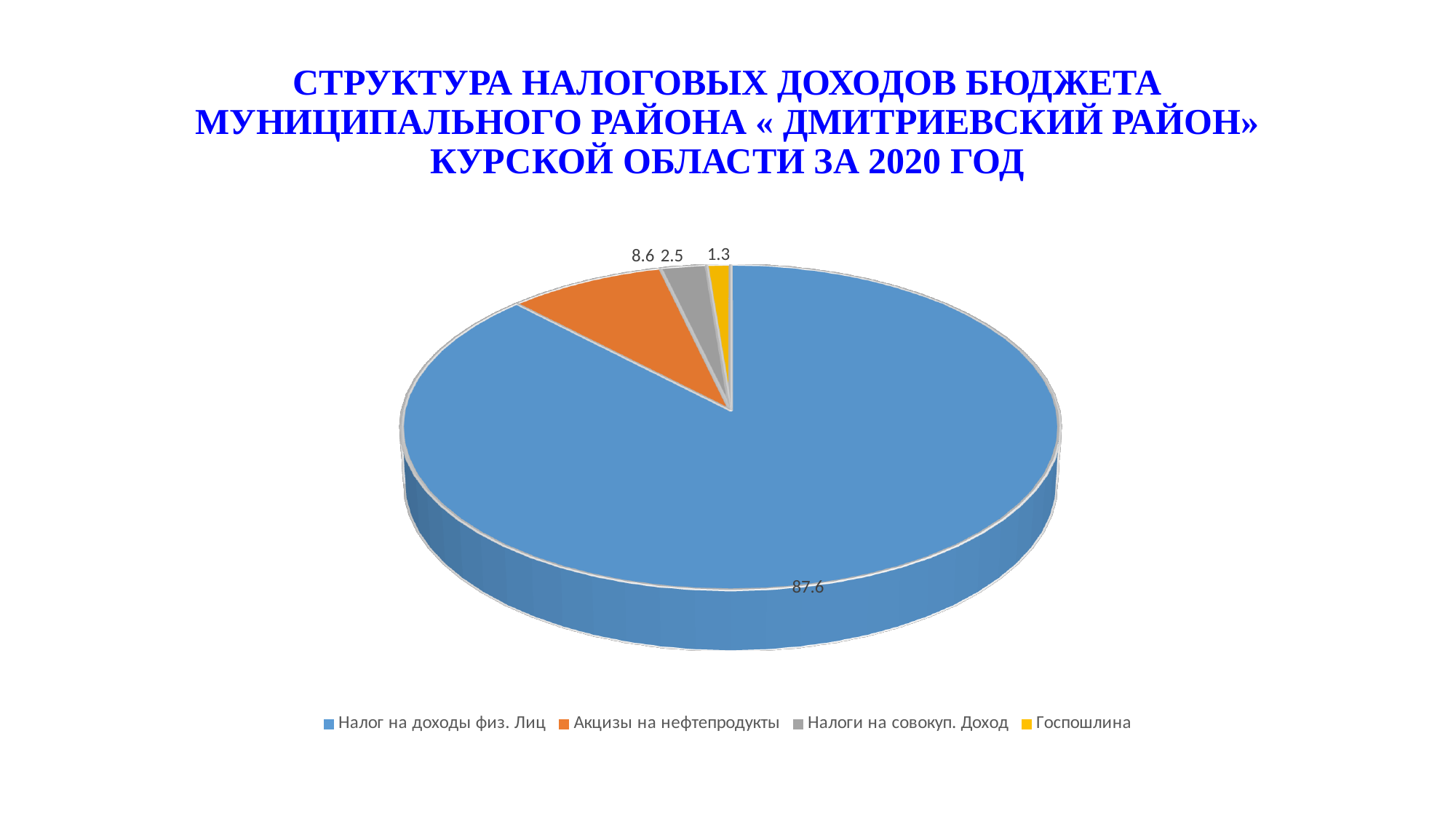
What is the value for Налог на доходы физ. Лиц? 87.6 What type of chart is shown on the slide? pie chart Which category has the smallest slice? Госпошлина What is the value for Госпошлина? 1.3 Which is larger, the value for Налоги на совокуп. Доход or the value for Госпошлина? Налоги на совокуп. Доход Which category has the largest slice? Налог на доходы физ. Лиц What colour is the slice for Акцизы на нефтепродукты? orange What is the value for Акцизы на нефтепродукты? 8.6 How many entries does the legend list? 4 How many categories does the pie chart have? 4 What is the difference between the values for Акцизы на нефтепродукты and Налоги на совокуп. Доход? 6.1 What is the value for Налоги на совокуп. Доход? 2.5